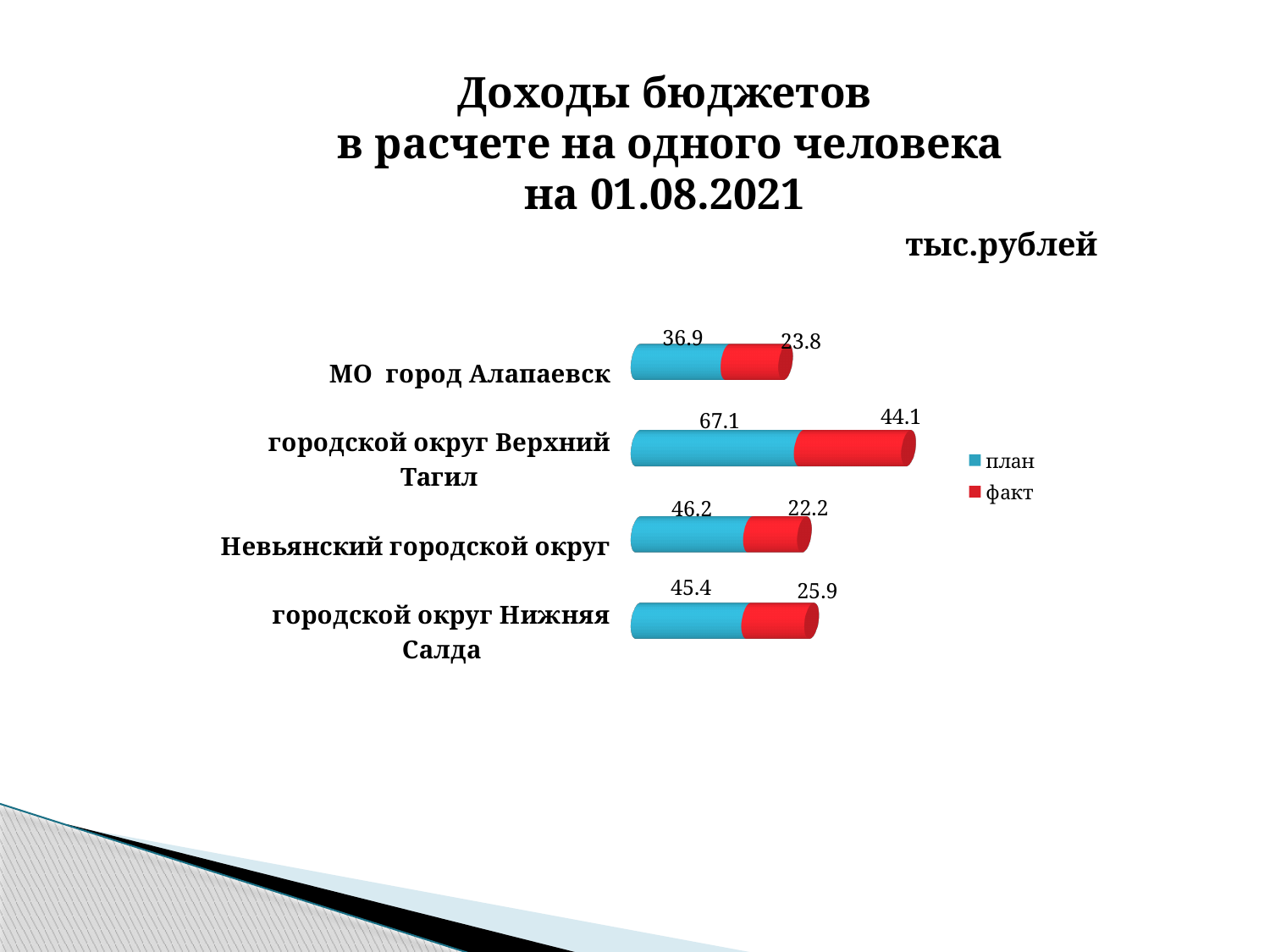
What unit is stated for the values on the slide? тыс.рублей Which is larger: the факт value for городской округ Нижняя Салда or the факт value for МО город Алапаевск? городской округ Нижняя Салда How many categories are shown on the chart? 4 What is the факт value for Невьянский городской округ? 22.2 What is the difference between the план and факт values for городской округ Верхний Тагил? 23.0 What kind of chart is shown on the slide? bar chart Which category has the highest план value? городской округ Верхний Тагил What is the факт value for МО город Алапаевск? 23.8 What is the план value for городской округ Верхний Тагил? 67.1 Which category has the lowest факт value? Невьянский городской округ What is the план value for городской округ Нижняя Салда? 45.4 How many series does the legend list? 2